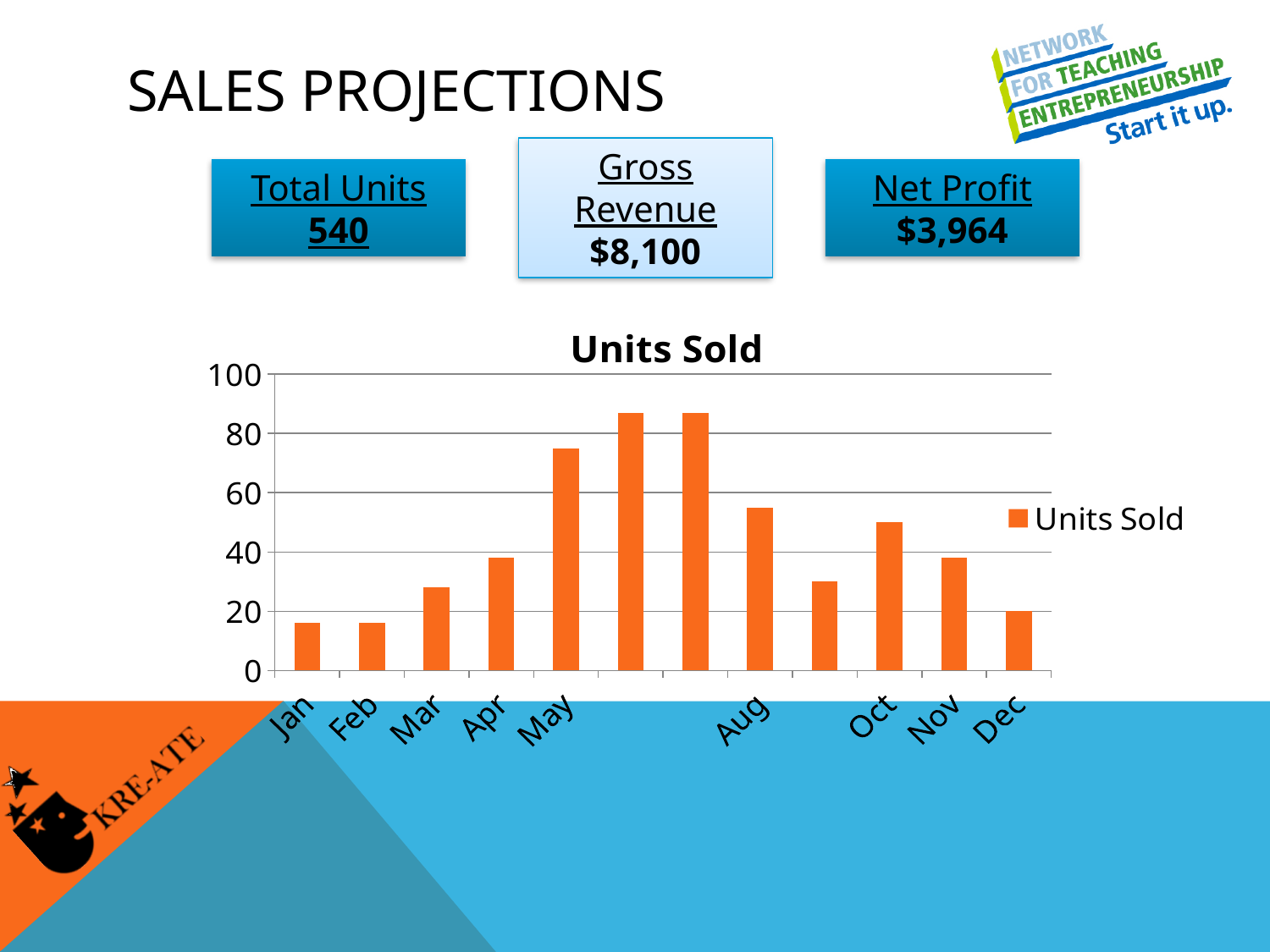
Is the value for Dec in the Units Sold chart greater or less than 40? less How many series does the legend of the Units Sold chart list? 1 Is the value for Mar in the Units Sold chart greater or less than 40? less How many bars are plotted in the Units Sold chart? 12 What is the title of the chart on the slide? Units Sold What kind of chart is the Units Sold chart? bar chart Is the value for Jan in the Units Sold chart greater or less than 40? less Do the values in the Units Sold chart rise or fall from Jan to May? rise In the Units Sold chart, which is larger, the value for May or the value for Aug? May